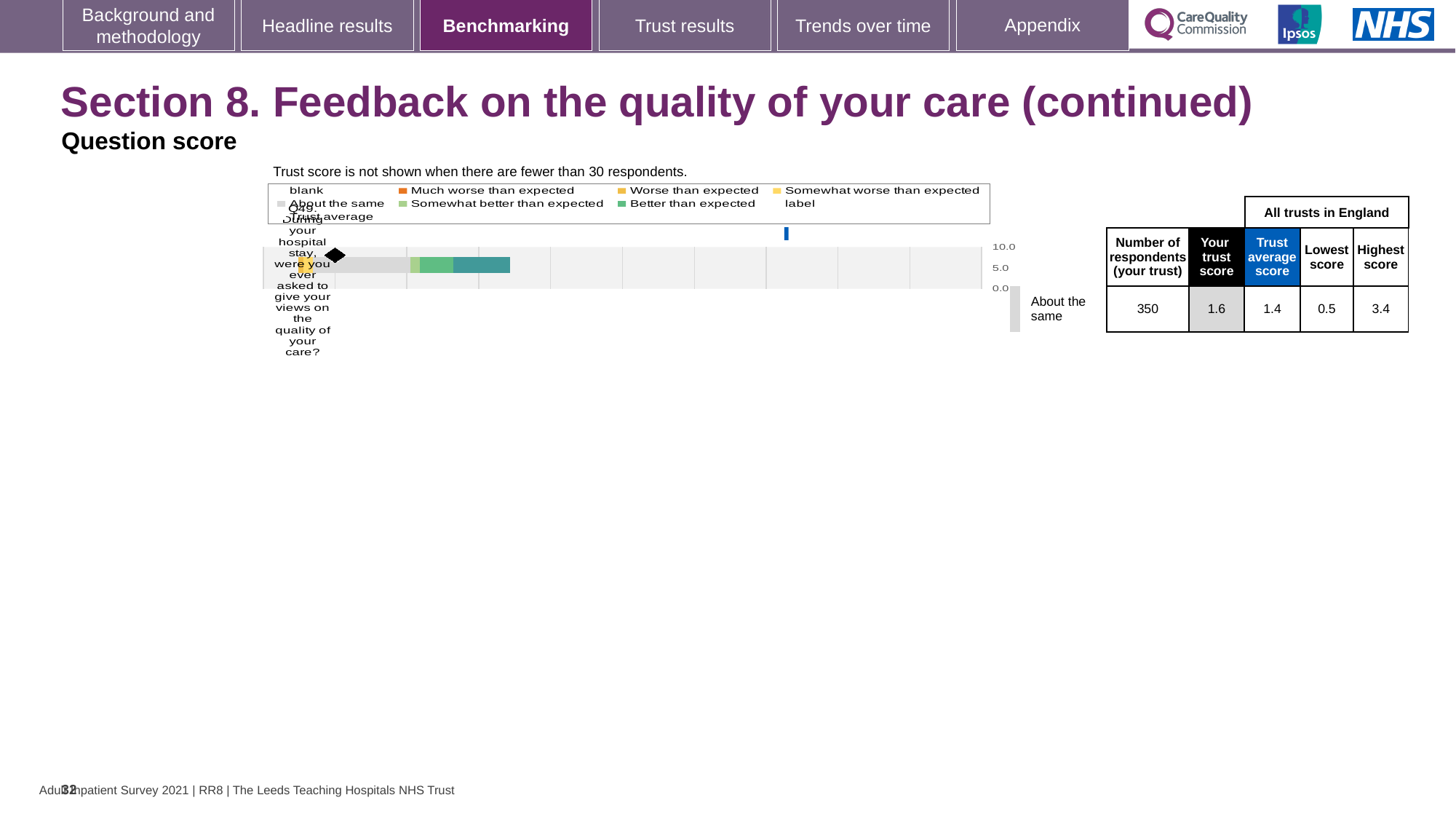
How many questions (bars) are plotted in the chart? 1 How is your trust's result for Q49 categorised relative to expectations? About the same What is your trust score for Q49? 1.6 What is the highest score among all trusts in England for Q49? 3.4 What is the lowest score among all trusts in England for Q49? 0.5 Which question is plotted in the chart? Q49. During your hospital stay, were you ever asked to give your views on the quality of your care? Which is larger for Q49, your trust score or the trust average score? Your trust score What kind of chart is shown on the slide? bar chart What is the number of respondents for your trust for Q49? 350 What is the difference between your trust score and the trust average score for Q49? 0.2 What is the trust average score for Q49? 1.4 What is the difference between the highest and lowest scores among all trusts in England for Q49? 2.9